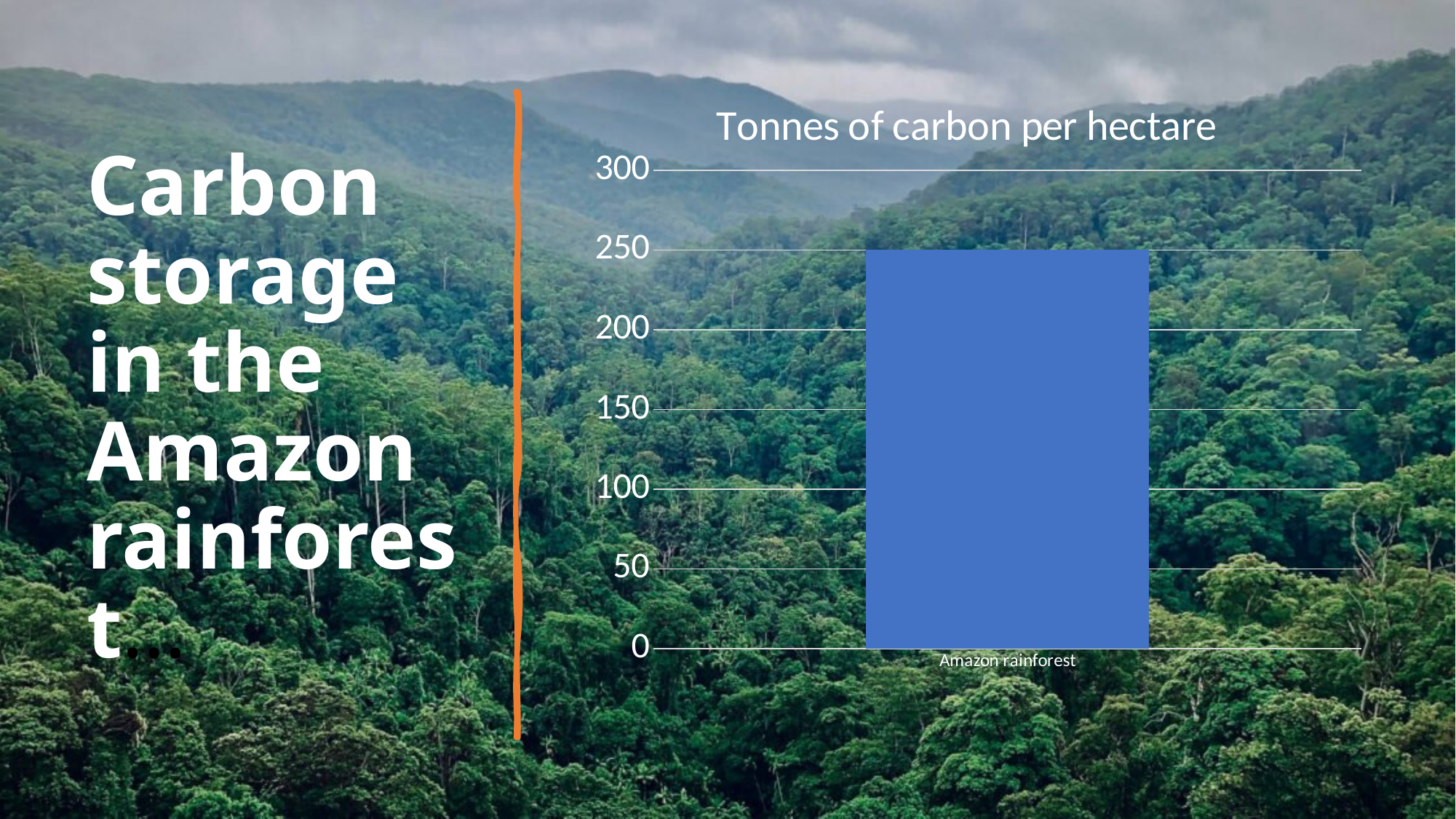
How many categories are plotted in the chart? 1 Is the value for Amazon rainforest greater or less than 200? greater What is the value for Amazon rainforest in the chart? 250 What kind of chart is shown on the slide? bar chart What is the label of the single category on the x axis? Amazon rainforest What colour is the bar in the chart? blue Is the value for Amazon rainforest greater or less than 300? less What is the title of the chart? Tonnes of carbon per hectare What is the highest value shown on the y axis of the chart? 300